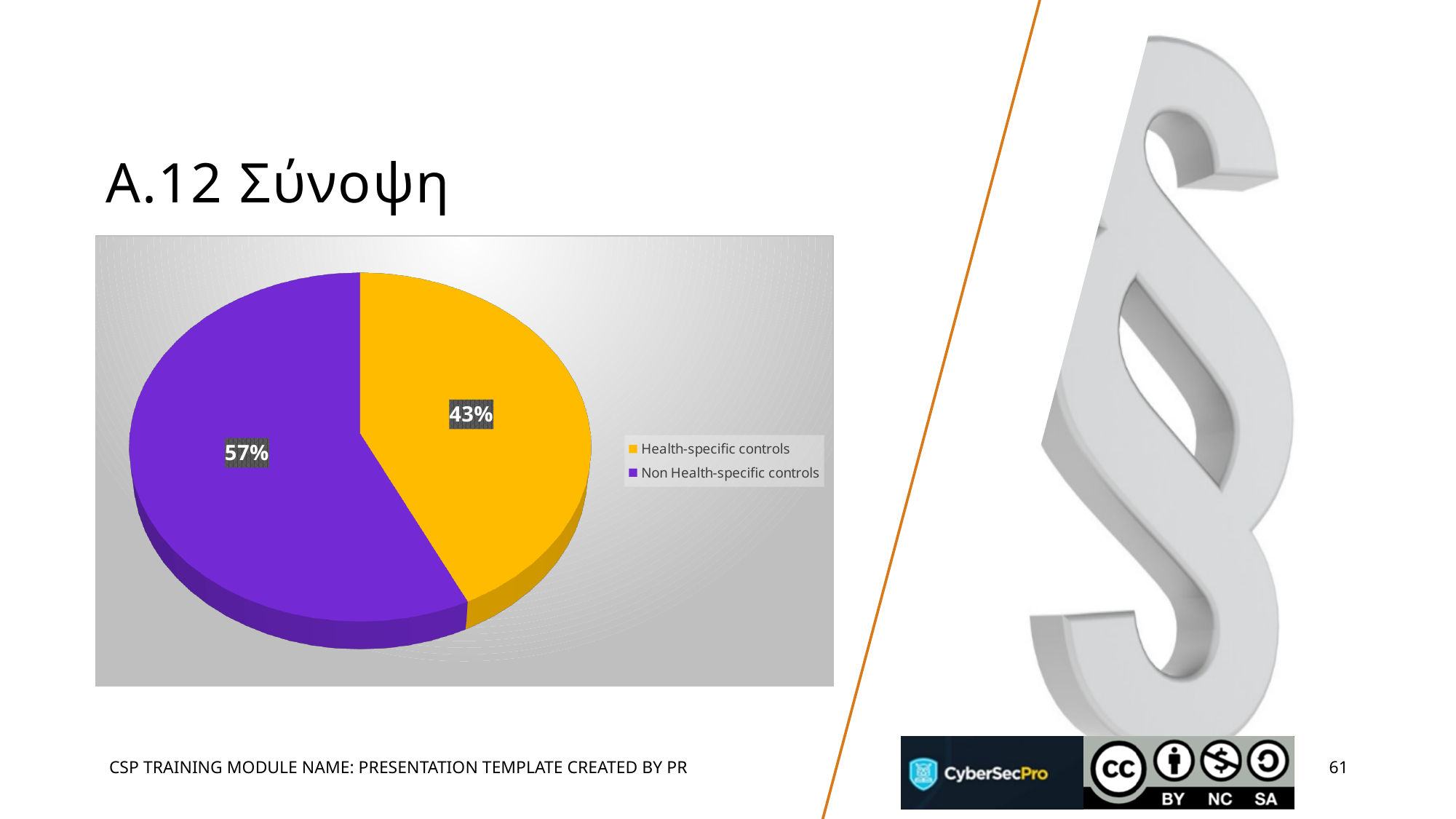
Which category has the smallest slice of the pie? Health-specific controls What colour is the Non Health-specific controls slice? Purple What colour is the Health-specific controls slice? Yellow Which slice is larger, Health-specific controls or Non Health-specific controls? Non Health-specific controls How many slices does the pie chart have? 2 Which category has the largest slice of the pie? Non Health-specific controls What share of the pie is labelled for Health-specific controls? 43% How many entries does the legend list? 2 What kind of chart is shown on the slide? Pie chart What share of the pie is labelled for Non Health-specific controls? 57% What is the difference in percentage points between the Non Health-specific controls slice and the Health-specific controls slice? 14